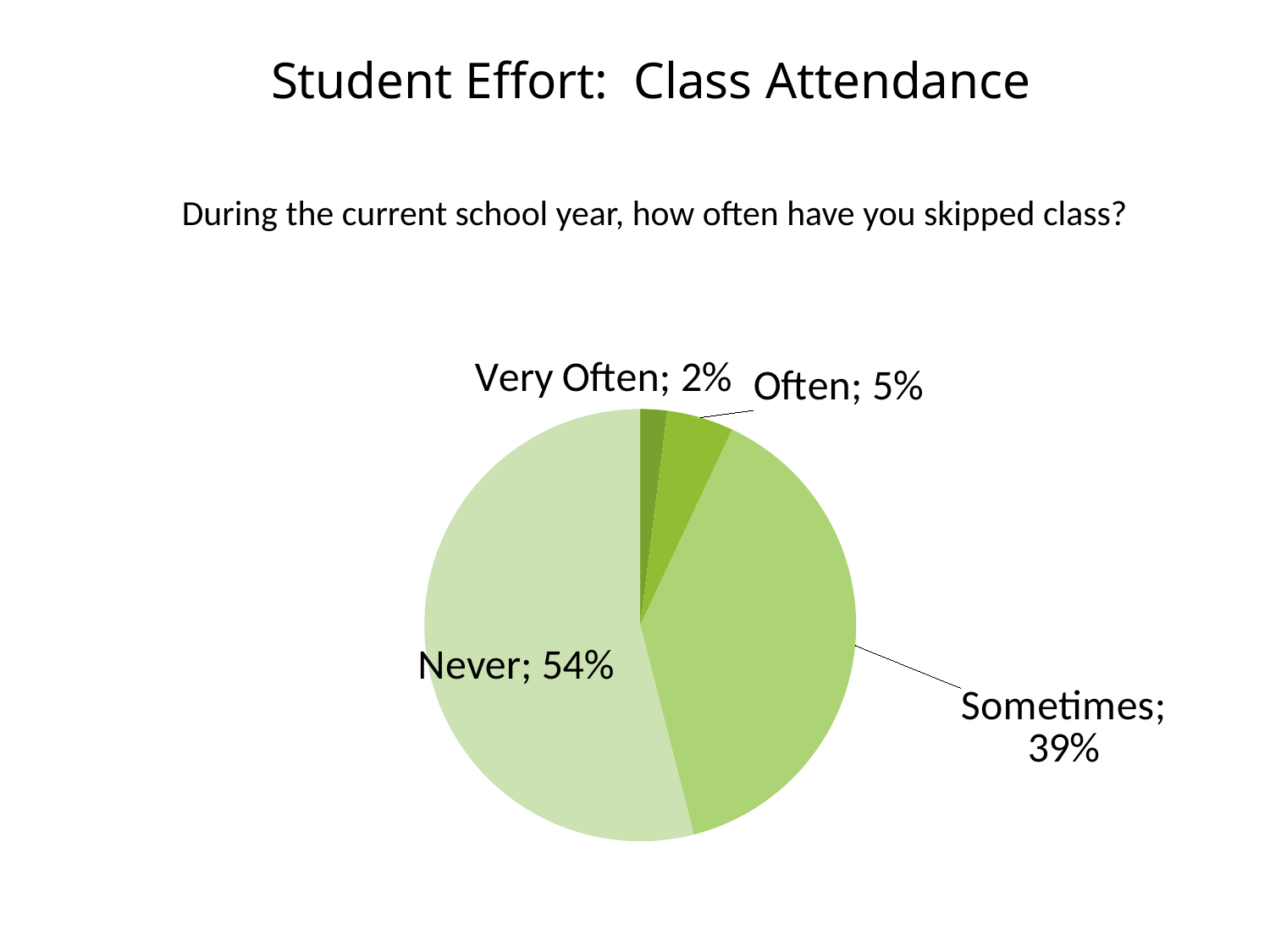
Which response has the smallest share of the pie? Very Often What kind of chart is shown on the slide? pie chart What percentage of students answered "Often"? 5% Which response has the largest share of the pie? Never What is the difference in percentage points between "Often" and "Very Often"? 3 What is the title of the slide containing the chart? Student Effort: Class Attendance What is the difference in percentage points between "Never" and "Sometimes"? 15 How many slices does the pie chart have? 4 What percentage of students answered "Very Often"? 2% What percentage of students answered "Never"? 54% What percentage of students answered "Sometimes"? 39% Which is larger, the share for "Sometimes" or the share for "Often"? Sometimes